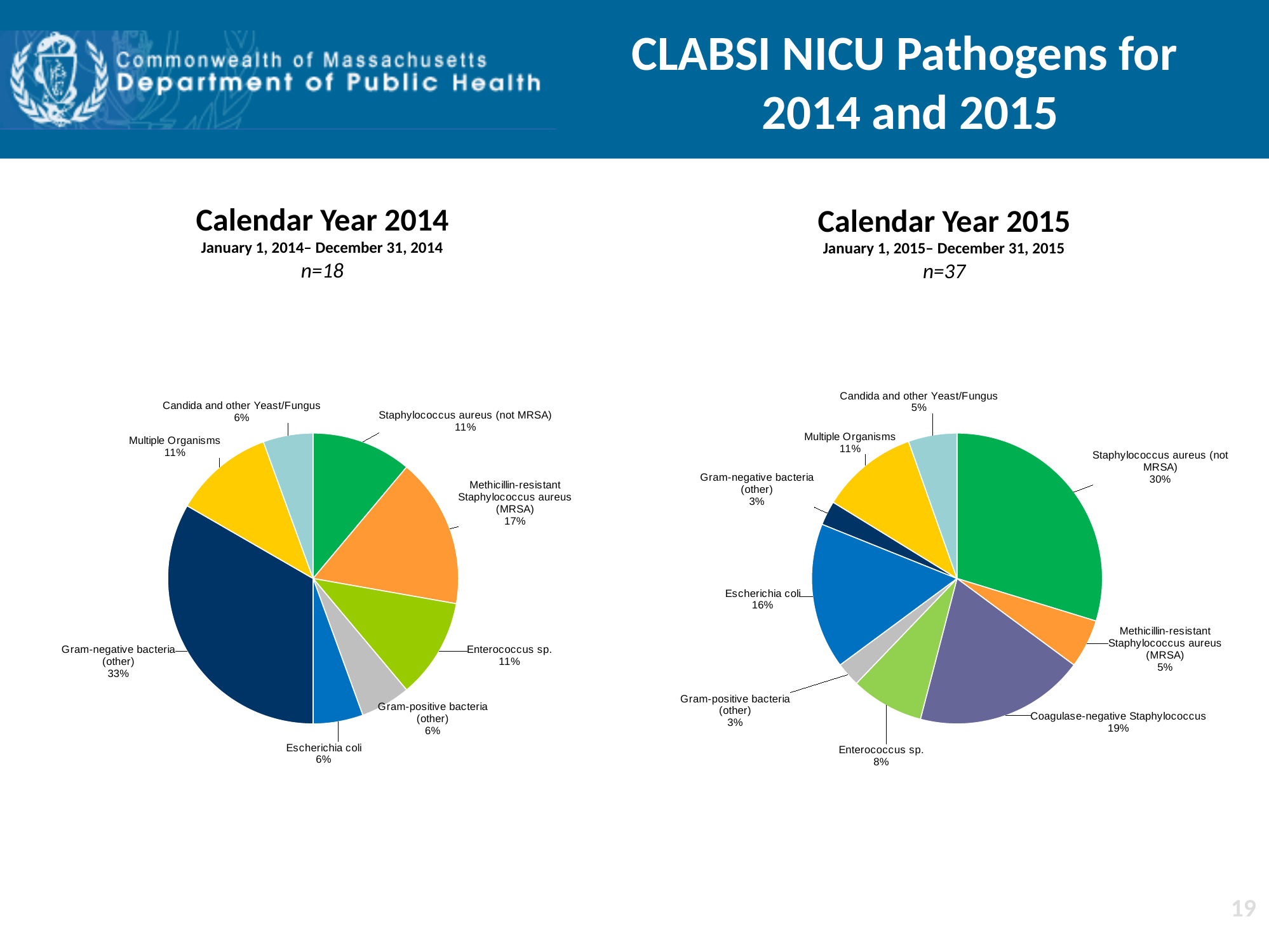
What type of chart is used to show the Calendar Year 2014 pathogens? Pie chart How many pathogen categories are shown in the Calendar Year 2015 pie chart? 9 In the Calendar Year 2014 chart, which pathogen category has the largest slice? Gram-negative bacteria (other) In the Calendar Year 2015 chart, which is larger: the Escherichia coli slice or the Enterococcus sp. slice? Escherichia coli What is the sample size (n) stated for the Calendar Year 2015 chart? n=37 What is the difference in percentage points between the MRSA share in the Calendar Year 2014 chart and the MRSA share in the Calendar Year 2015 chart? 12 percentage points In the Calendar Year 2015 chart, what share is Coagulase-negative Staphylococcus? 19% How many pathogen categories are shown in the Calendar Year 2014 pie chart? 8 In the Calendar Year 2014 chart, what share is Methicillin-resistant Staphylococcus aureus (MRSA)? 17% In the Calendar Year 2015 chart, what share of pathogens is Staphylococcus aureus (not MRSA)? 30% In the Calendar Year 2014 chart, what share of pathogens is Gram-negative bacteria (other)? 33% In the Calendar Year 2015 chart, which pathogen category has the largest slice? Staphylococcus aureus (not MRSA)